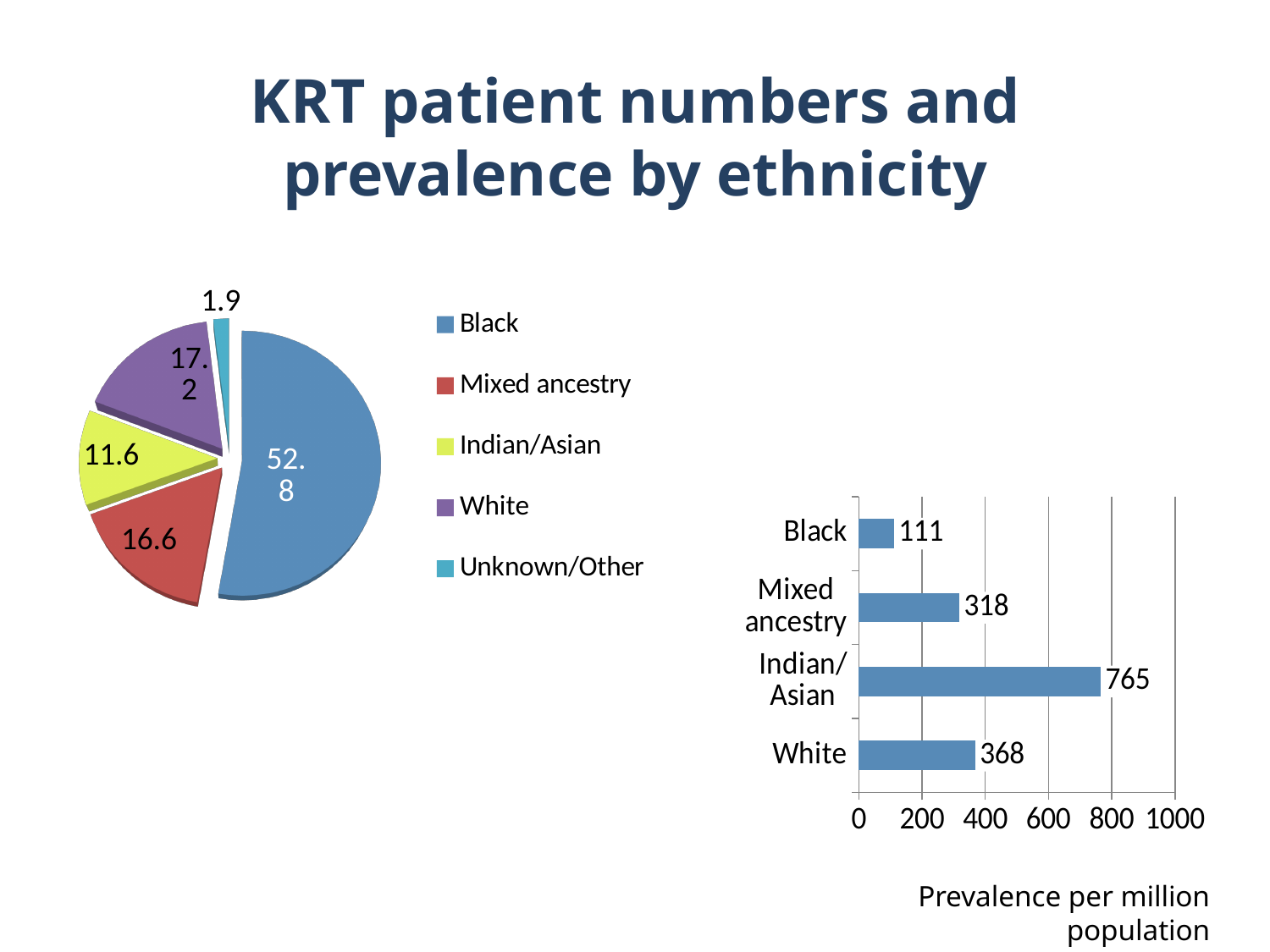
In the bar chart on the right, what is the prevalence per million population for Black? 111 In the bar chart on the right, which is larger, the value for White or the value for Mixed ancestry? White In the bar chart on the right, what is the prevalence per million population for Indian/Asian? 765 In the pie chart on the left, what is the value shown for the Indian/Asian slice? 11.6 In the pie chart on the left, which category has the largest slice? Black In the pie chart on the left, what is the value shown for the Black slice? 52.8 In the bar chart on the right, which category has the highest prevalence per million population? Indian/Asian In the pie chart on the left, which category has the smallest slice? Unknown/Other What type of chart is shown on the right of the slide? Bar chart In the pie chart on the left, what is the difference between the White and Mixed ancestry values? 0.6 In the pie chart on the left, how many categories does the legend list? 5 In the bar chart on the right, what is the difference between the Indian/Asian and White values? 397